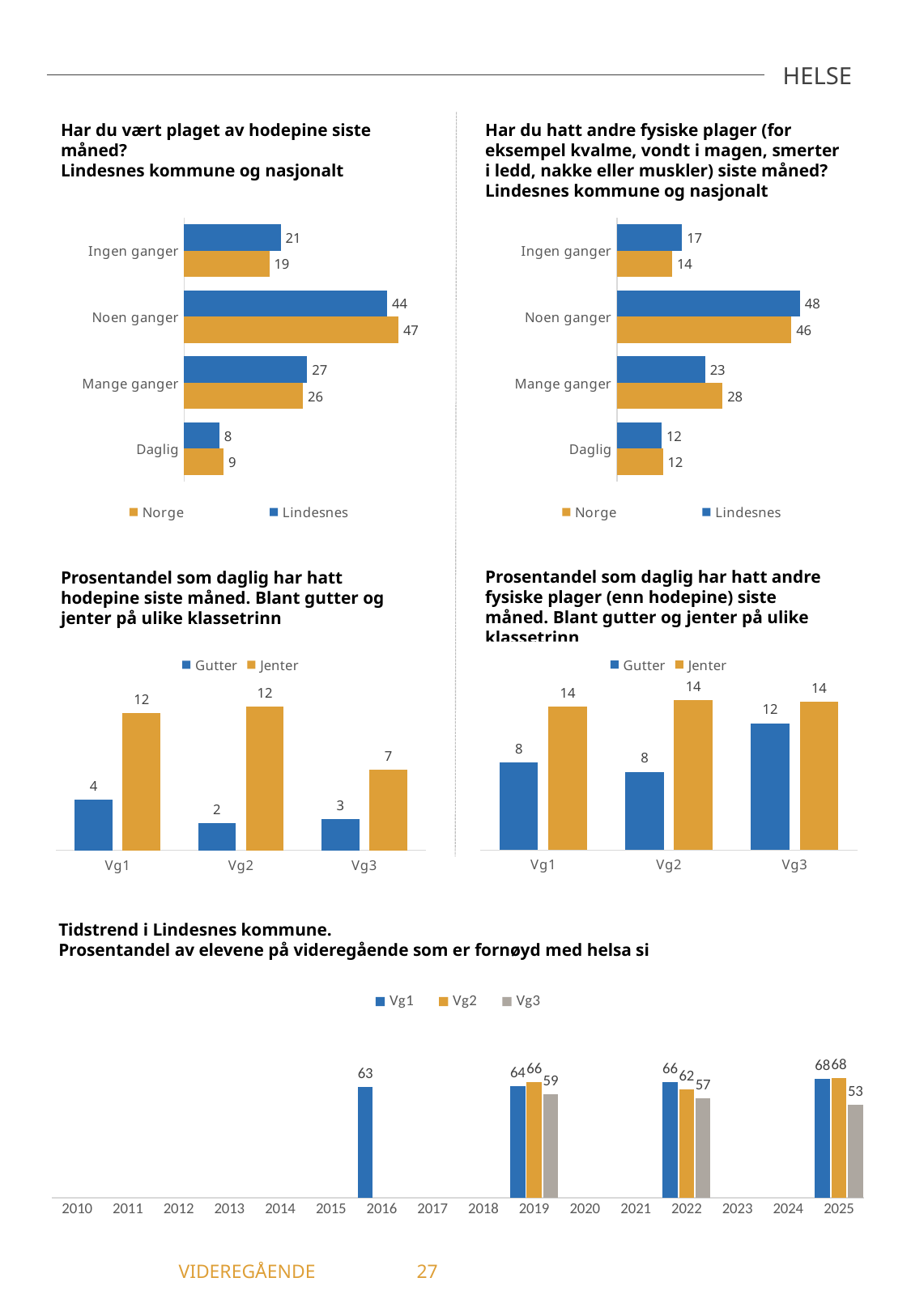
In the chart 'Har du hatt andre fysiske plager ... siste måned?', which category has the highest value for Lindesnes? Noen ganger In the chart 'Har du hatt andre fysiske plager ... siste måned?', how many series does the legend list? 2 In the chart 'Tidstrend i Lindesnes kommune', does the value for Vg3 rise or fall from 2019 to 2025? fall In the chart 'Har du hatt andre fysiske plager ... siste måned?', what is the value for Norge for 'Mange ganger'? 28 What kind of chart is 'Tidstrend i Lindesnes kommune'? bar chart In the chart 'Prosentandel som daglig har hatt hodepine siste måned', what is the value for Jenter at Vg3? 7 In the chart 'Prosentandel som daglig har hatt andre fysiske plager (enn hodepine) siste måned', which is larger at Vg1: Gutter or Jenter? Jenter In the chart 'Prosentandel som daglig har hatt andre fysiske plager (enn hodepine) siste måned', what is the value for Gutter at Vg3? 12 In the chart 'Prosentandel som daglig har hatt hodepine siste måned', which class level has the lowest value for Gutter? Vg2 In the chart 'Har du vært plaget av hodepine siste måned?', what is the difference between Norge and Lindesnes for 'Noen ganger'? 3 In the chart 'Tidstrend i Lindesnes kommune', what is the value for Vg3 in 2025? 53 In the chart 'Har du vært plaget av hodepine siste måned?', what is the value for Lindesnes for 'Noen ganger'? 44